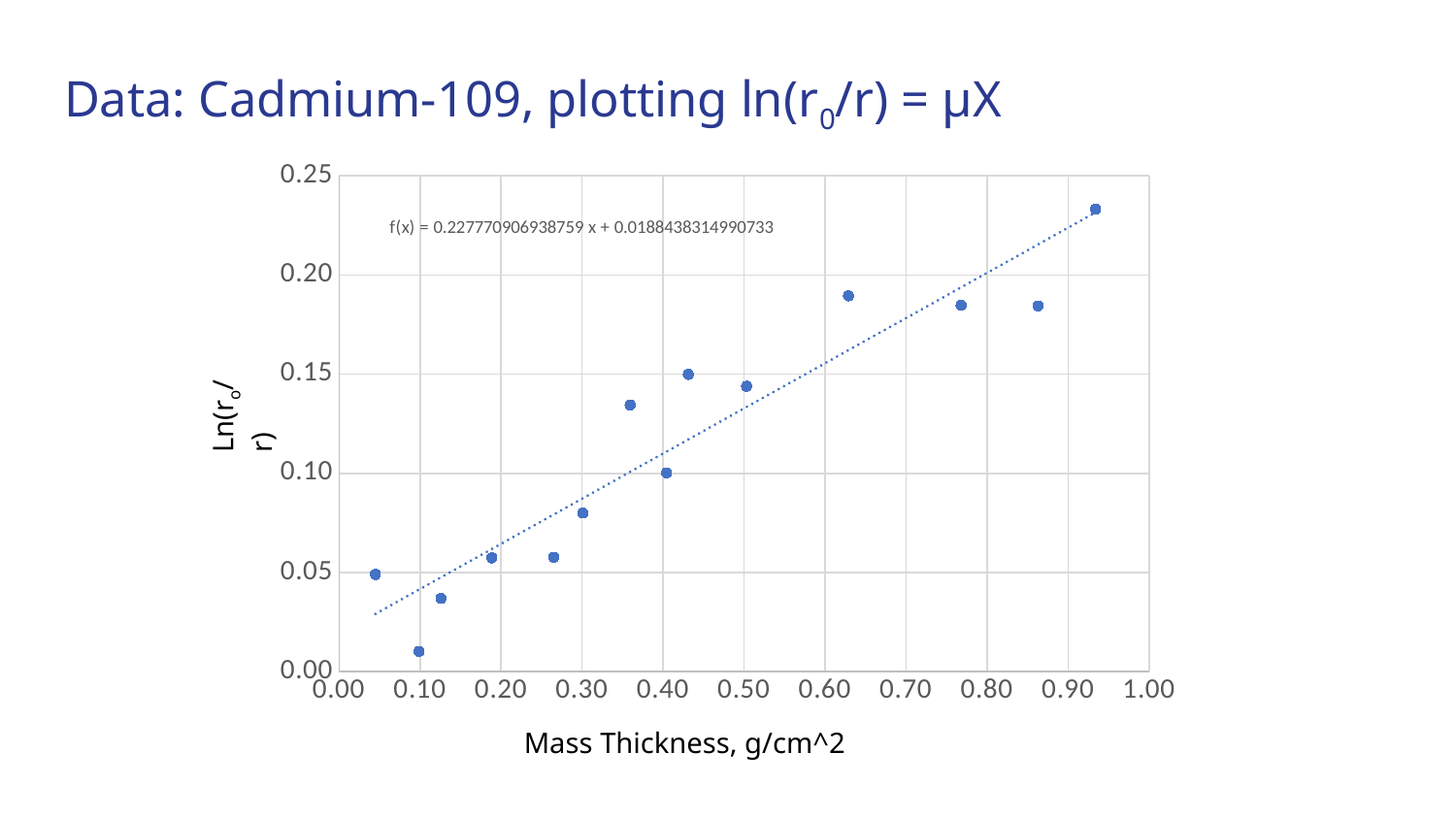
Do the plotted ln(r0/r) values generally rise or fall as mass thickness increases? rise Which data point has the highest ln(r0/r) value: the leftmost point or the rightmost point? the rightmost point What kind of chart is shown on the slide? scatter plot What is the title of the x axis? Mass Thickness, g/cm^2 Which has the higher ln(r0/r) value: the data point at about 0.36 g/cm^2 or the data point at about 0.40 g/cm^2? the point at about 0.36 g/cm^2 Is the value for the rightmost data point (mass thickness about 0.93 g/cm^2) greater or less than 0.20? greater Is the value for the data point at a mass thickness of about 0.10 g/cm^2 greater or less than 0.05? less What is the slope of the fitted trendline equation shown on the chart? 0.227770906938759 How many data points are plotted on the chart? 14 Is the value for the data point at a mass thickness of about 0.63 g/cm^2 greater or less than 0.15? greater